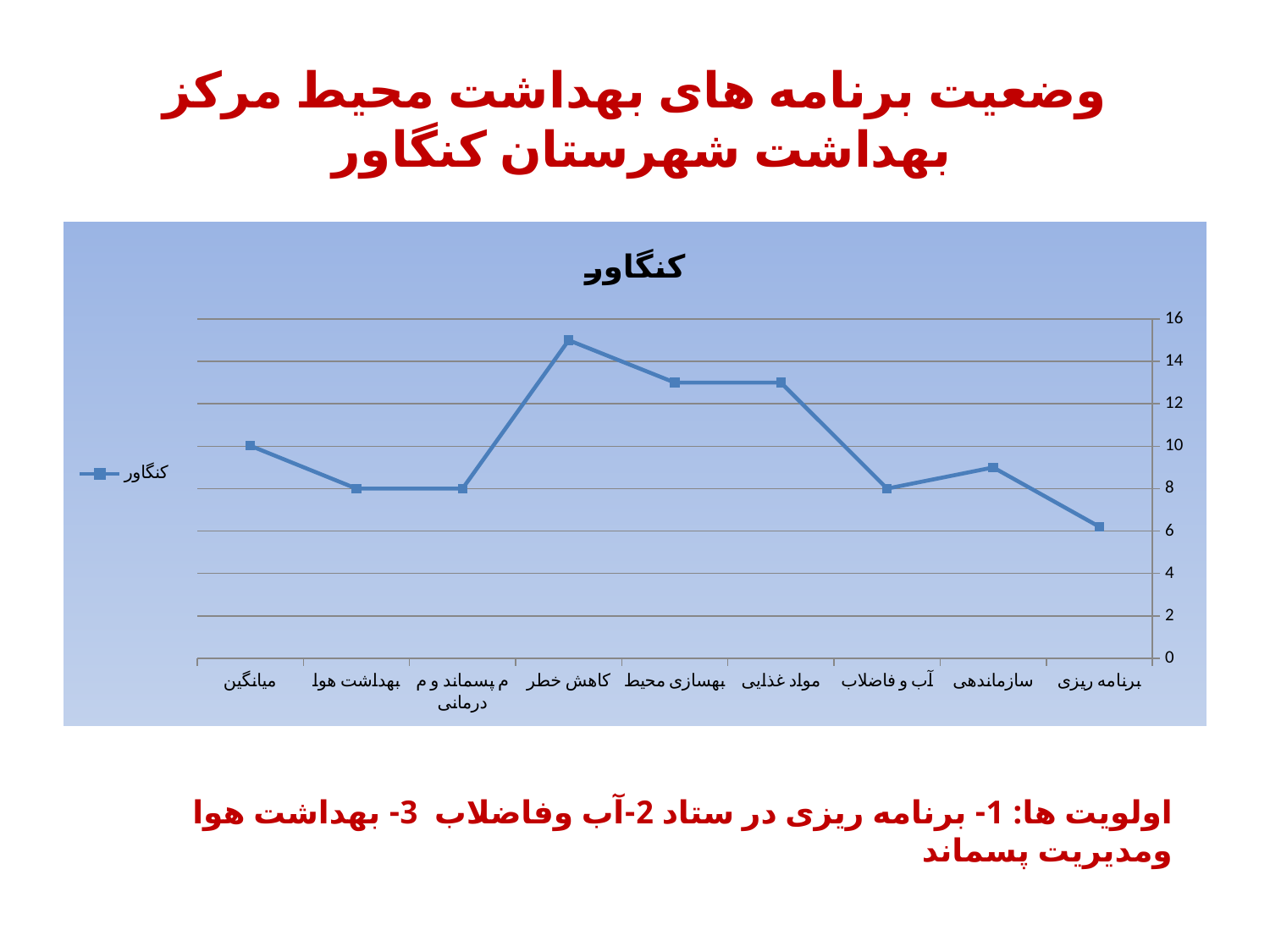
Does the value rise or fall from آب و فاضلاب to مواد غذایی? rise Is the value for سازماندهی greater or less than 10? less How many series does the legend list? 1 Is the value for کاهش خطر greater or less than 14? greater What is the title of the chart? کنگاور How many categories are plotted along the x axis? 9 What kind of chart is shown on the slide? line chart Which category has the lowest value? برنامه ریزی Which is larger, the value for کاهش خطر or the value for میانگین? کاهش خطر What is the value for بهداشت هوا? 8 Which category has the highest value? کاهش خطر